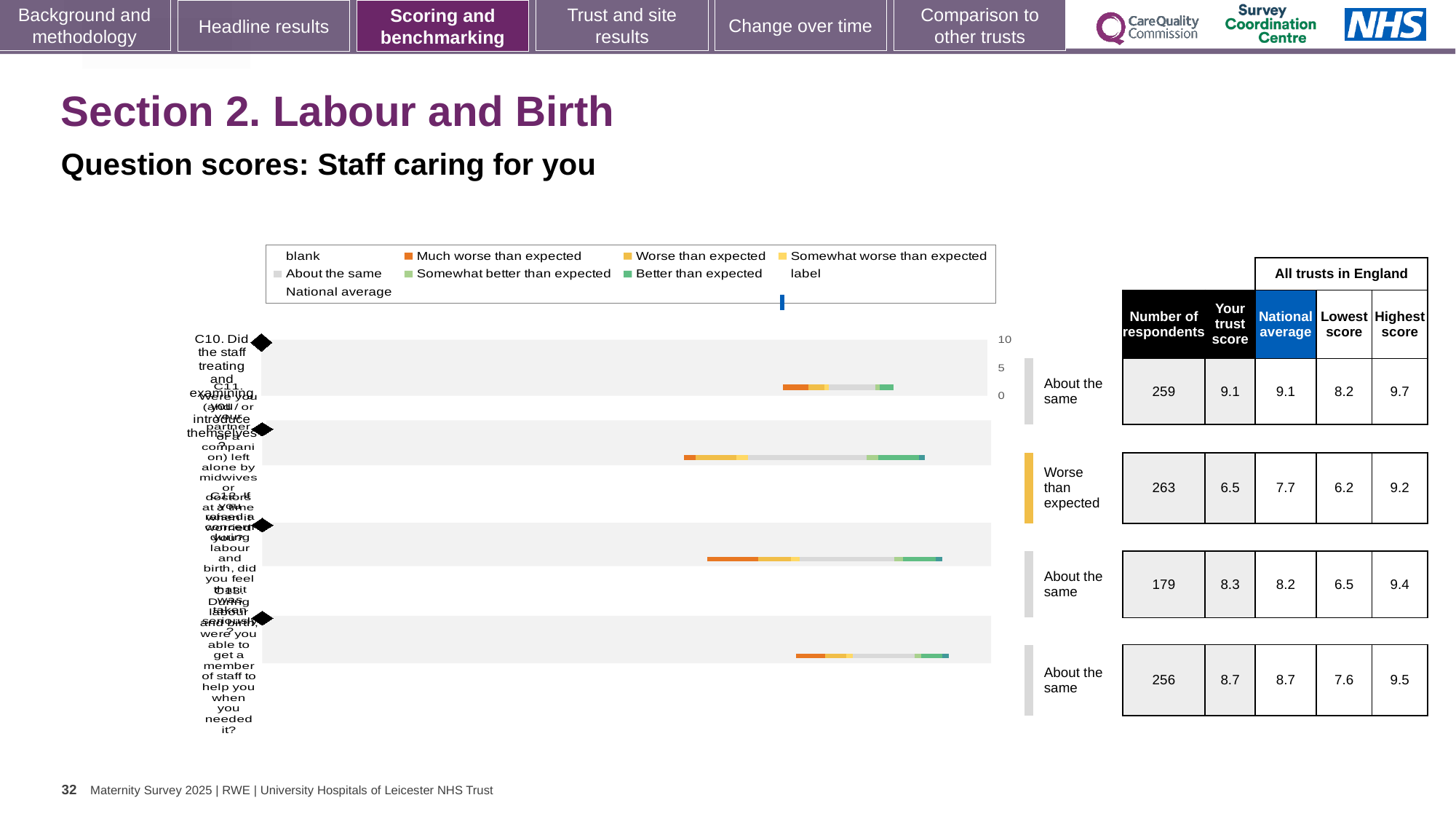
In the table, what is the 'Your trust score' for the row rated 'Worse than expected'? 6.5 What is the highest score shown for the fourth (bottom) row of the table? 9.5 For the third row, which is larger: the trust score or the national average? the trust score (8.3) In the table, what is the number of respondents for the first row (C10)? 259 In the table, what is the national average for the row rated 'Worse than expected'? 7.7 Which row has the highest 'Your trust score' in the table? the first row (C10), 9.1 Which legend entry is shown in dark orange? Much worse than expected What benchmark label is shown next to the second row of the chart? Worse than expected Which row has the lowest number of respondents in the table? the third row, 179 What kind of chart is shown on the slide? bar chart For the row rated 'Worse than expected', what is the difference between the highest score and the lowest score? 3.0 How many question rows are plotted in the chart? 4